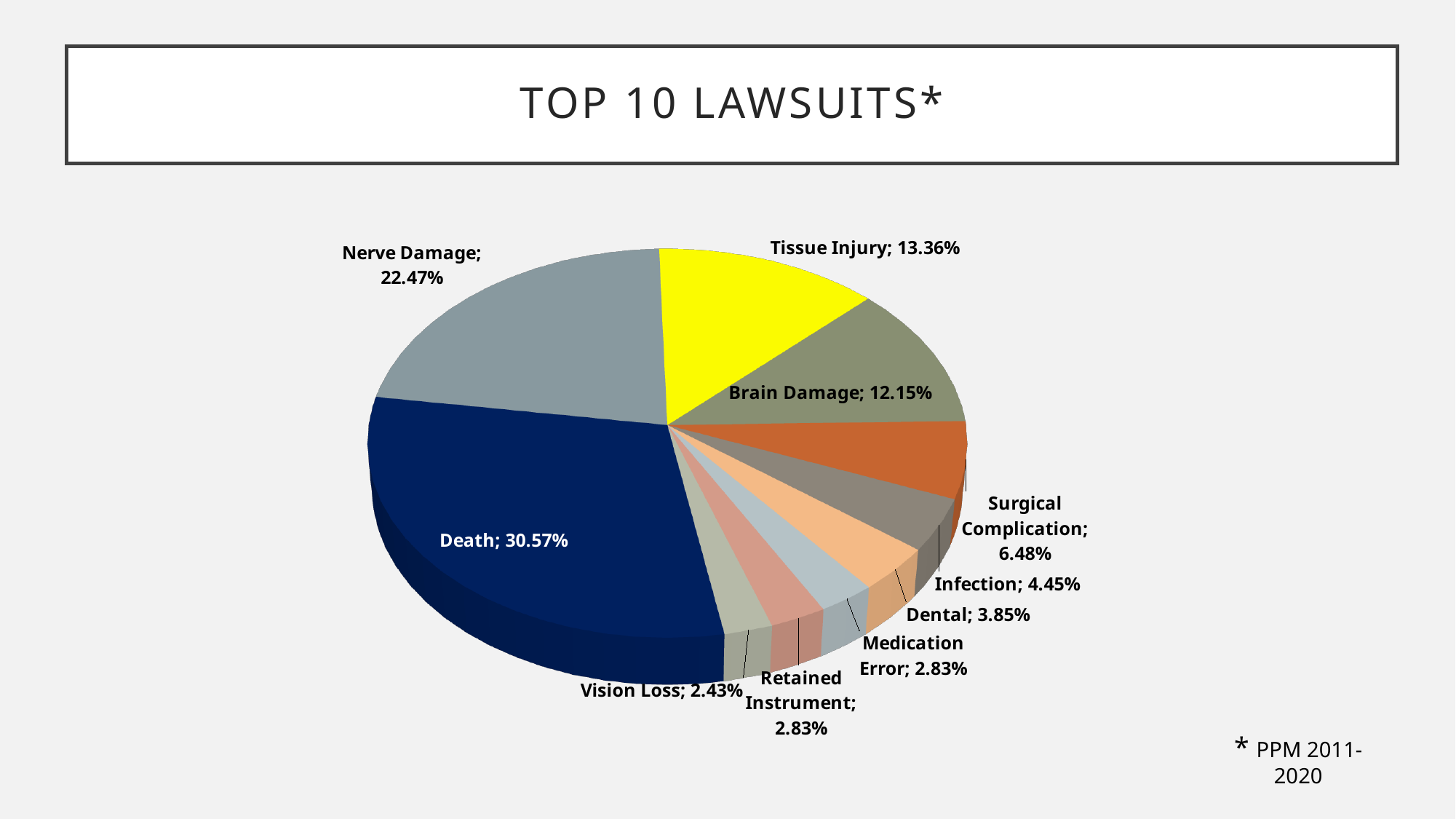
What is the title of the chart? TOP 10 LAWSUITS* What is the difference between the Death and Nerve Damage percentages? 8.10% What is the difference between the Tissue Injury and Brain Damage percentages? 1.21% What percentage is shown for Infection? 4.45% What percentage is shown for Nerve Damage? 22.47% How many categories are shown in the pie chart? 10 What share of lawsuits is attributed to Death? 30.57% Which is larger, Nerve Damage or Tissue Injury? Nerve Damage Which category has the smallest slice of the pie? Vision Loss What kind of chart is shown on the slide? pie chart Which category has the largest slice of the pie? Death What is the value for Surgical Complication? 6.48%